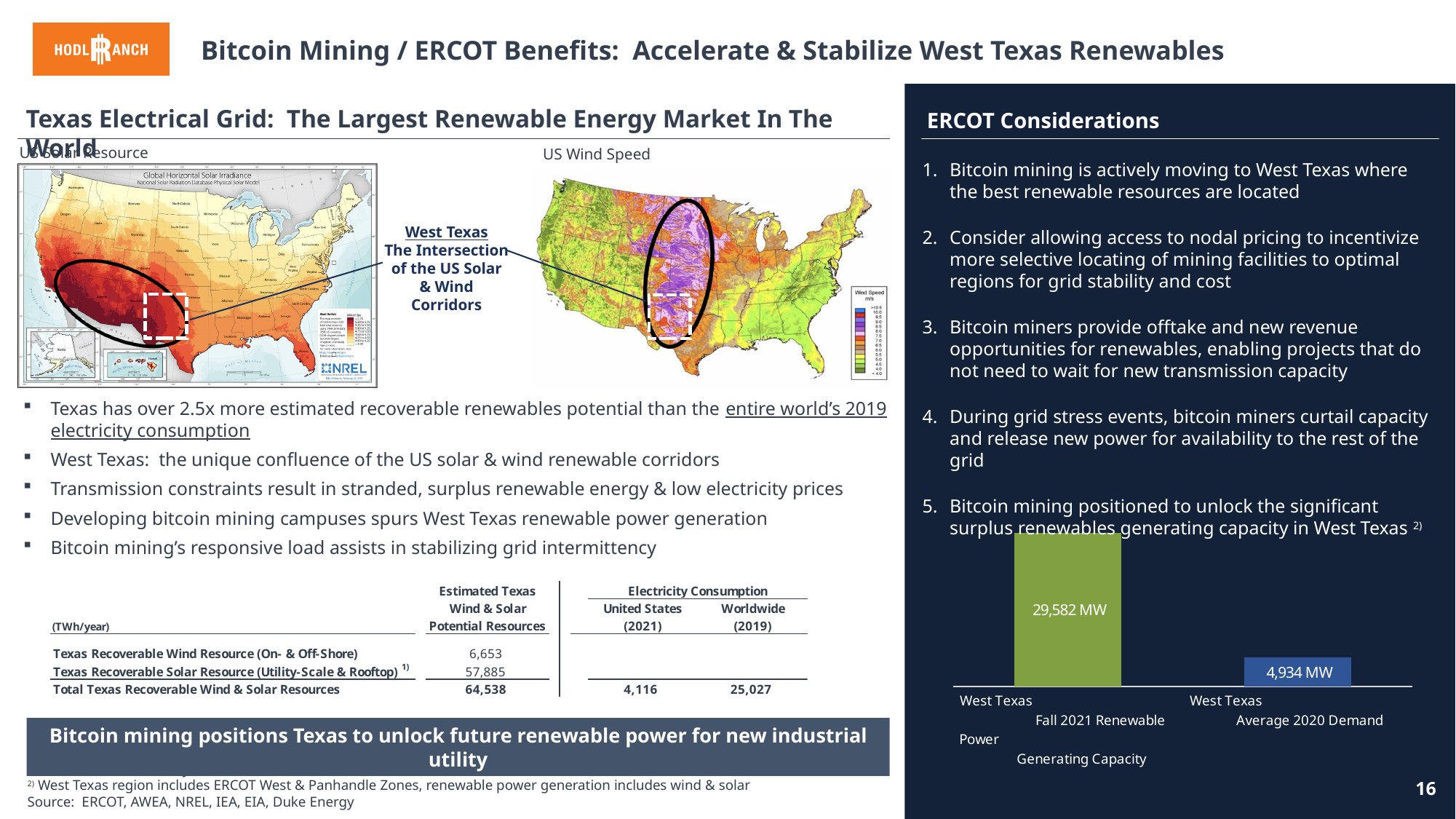
In the bar chart on the right, what colour is the bar for West Texas Average 2020 Demand? Blue What kind of chart is shown in the bottom right of the slide? Bar chart In the bar chart on the right, which category has the highest value? West Texas Fall 2021 Renewable Power Generating Capacity In the bar chart on the right, which is larger: West Texas Fall 2021 Renewable Power Generating Capacity or West Texas Average 2020 Demand? West Texas Fall 2021 Renewable Power Generating Capacity In the bar chart on the right, which category has the lowest value? West Texas Average 2020 Demand How many bars are shown in the bar chart on the right? 2 In the bar chart on the right, what is the value for West Texas Fall 2021 Renewable Power Generating Capacity? 29,582 MW In the bar chart on the right, what is the value for West Texas Average 2020 Demand? 4,934 MW In the bar chart on the right, what is the difference between the West Texas Fall 2021 Renewable Power Generating Capacity and the West Texas Average 2020 Demand? 24,648 MW In the bar chart on the right, what colour is the bar for West Texas Fall 2021 Renewable Power Generating Capacity? Green In the bar chart on the right, what unit are the data labels expressed in? MW